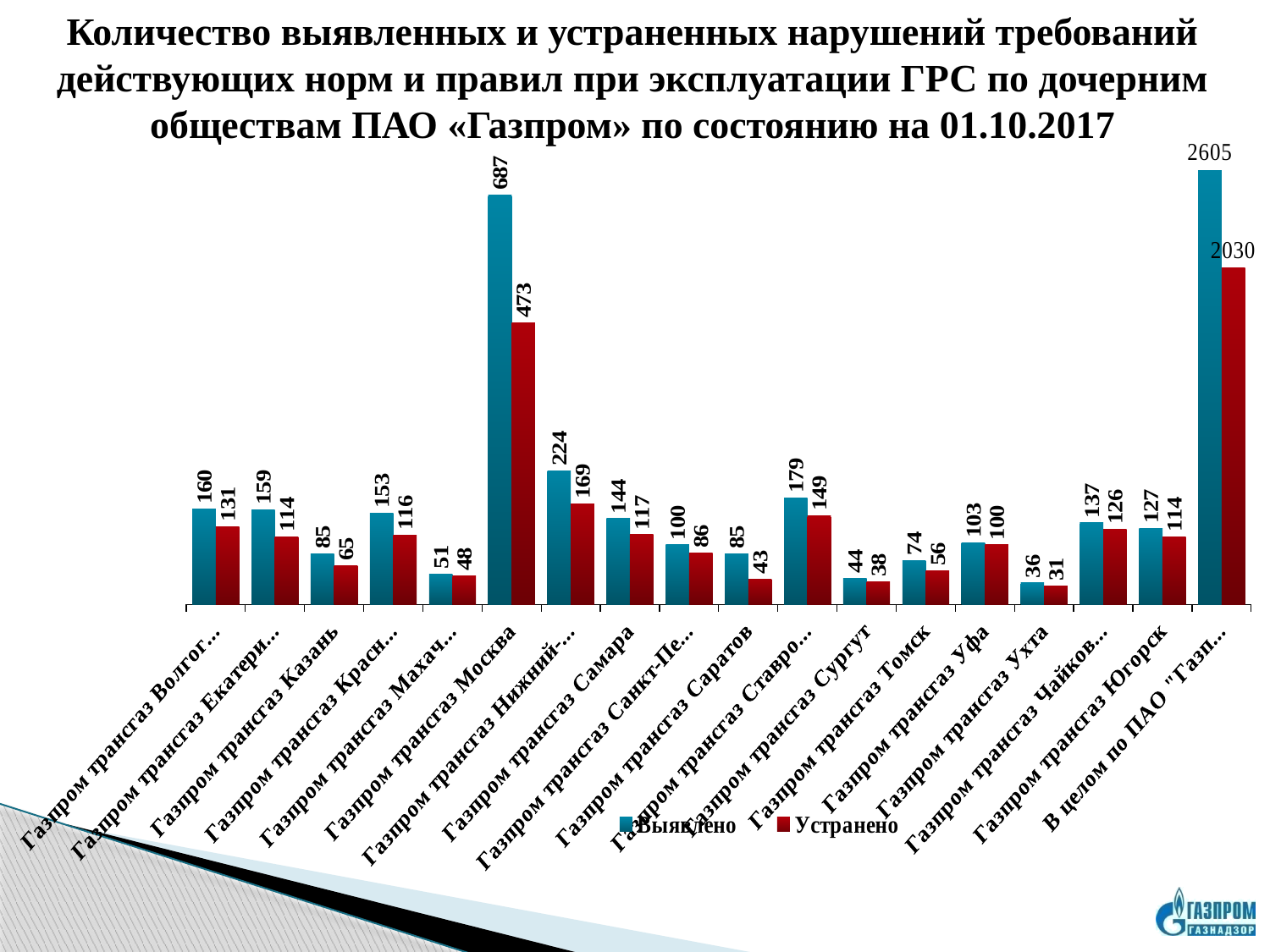
Which category has the lowest Устранено value? Газпром трансгаз Ухта Which is larger: the Выявлено value for Газпром трансгаз Сургут or for Газпром трансгаз Томск? Газпром трансгаз Томск Among the individual subsidiaries (excluding the overall total), which category has the highest Выявлено value? Газпром трансгаз Москва What is the value of Выявлено for Газпром трансгаз Москва? 687 What is the value of Устранено for Газпром трансгаз Уфа? 100 How many series does the legend list? 2 What is the value of Устранено for Газпром трансгаз Казань? 65 What is the value of Выявлено for Газпром трансгаз Томск? 74 How many categories are shown on the x axis? 18 What kind of chart is shown on the slide? Bar chart What is the difference between Выявлено and Устранено for Газпром трансгаз Саратов? 42 What are the two series named in the legend? Выявлено and Устранено